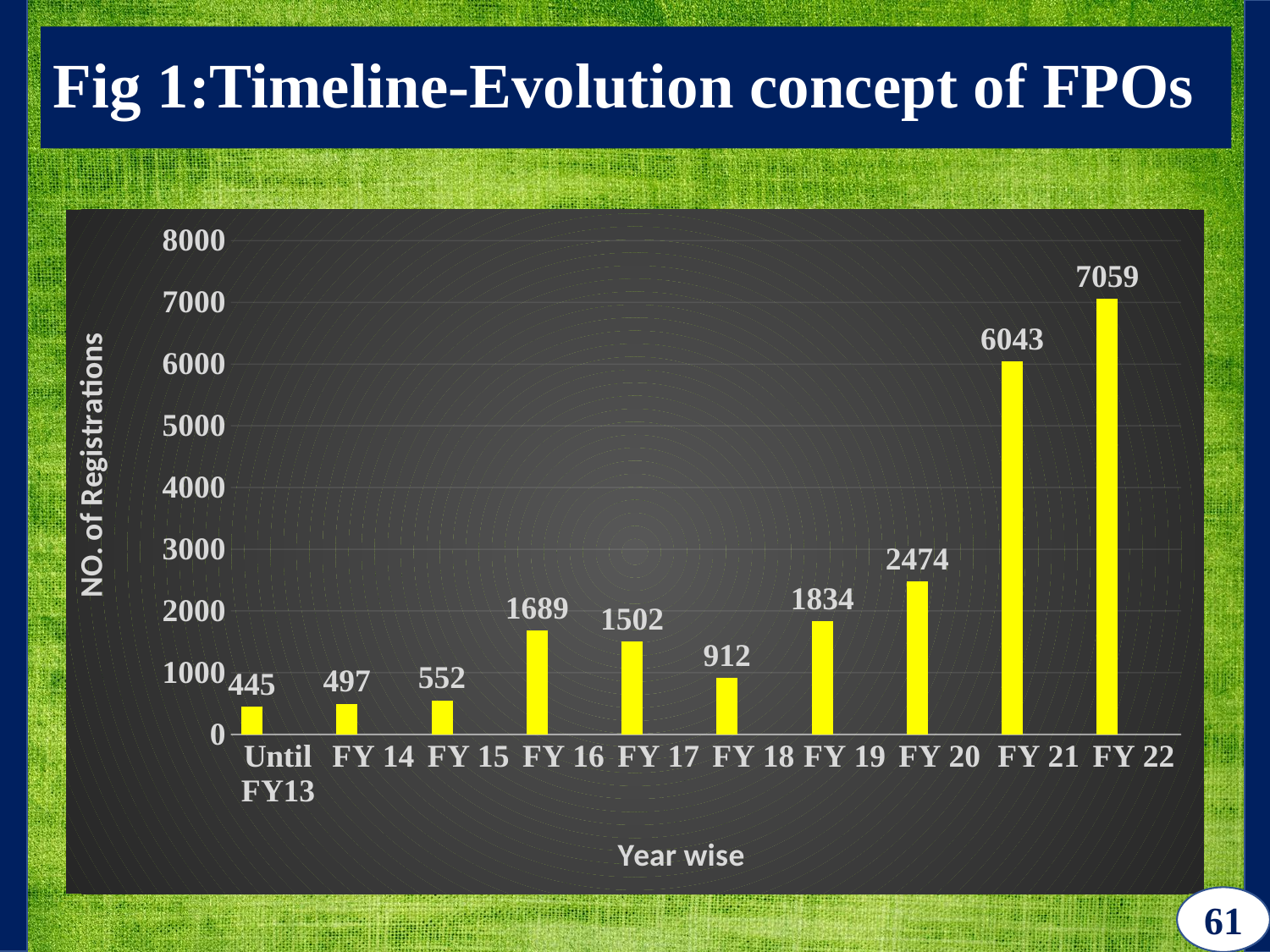
What is the label of the y axis? NO. of Registrations What is the difference in registrations between FY 22 and FY 21? 1016 What type of chart is shown on the slide? bar chart What is the number of registrations for Until FY13? 445 Which year has the highest number of registrations? FY 22 Which category has the lowest number of registrations? Until FY13 Which has more registrations, FY 16 or FY 17? FY 16 What is the difference in registrations between FY 20 and FY 19? 640 What is the number of registrations for FY 22? 7059 What is the number of registrations for FY 16? 1689 How many categories are shown on the x axis? 10 Is the value for FY 18 greater or less than 1000? less